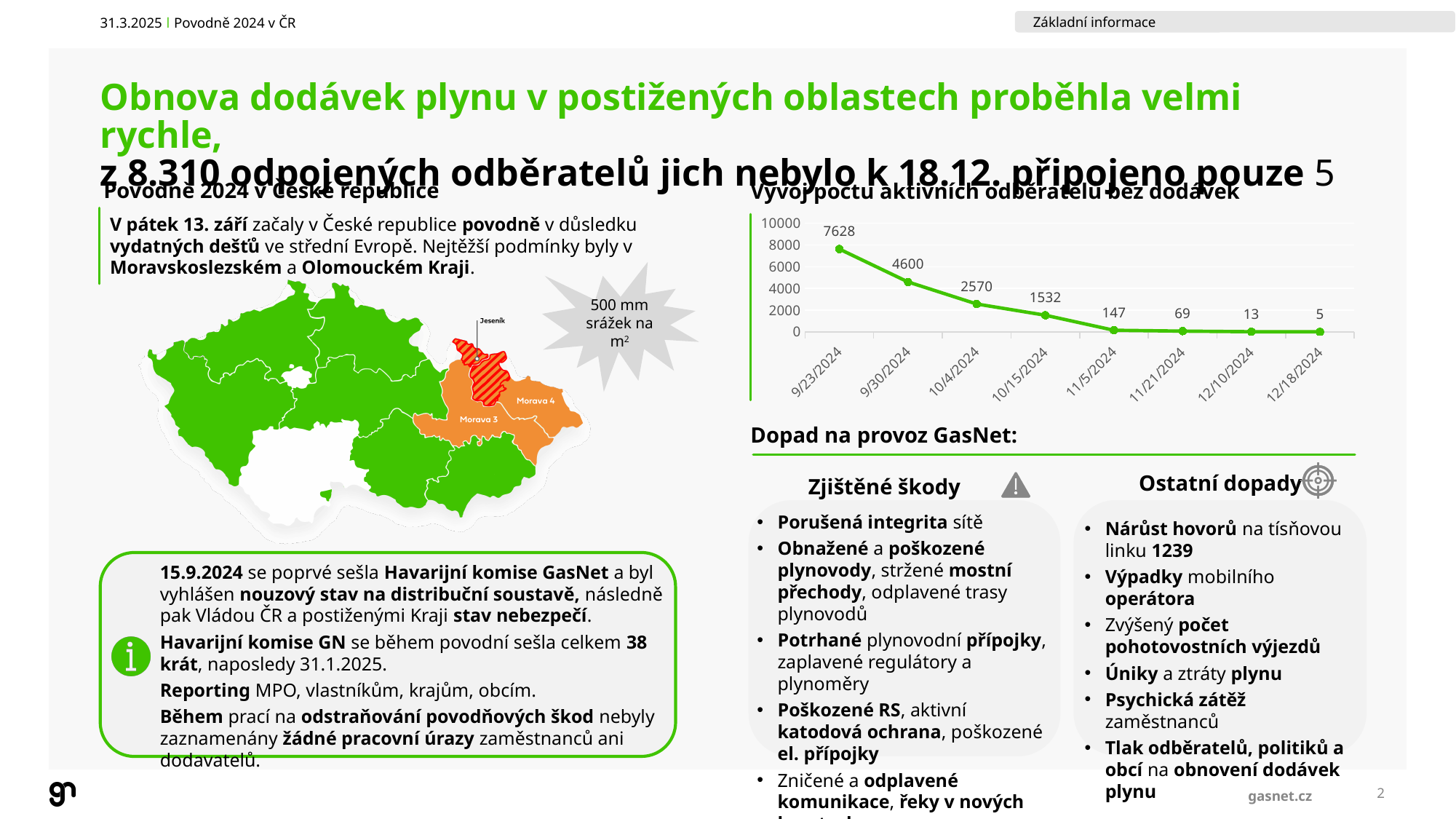
What is the value for 11/5/2024 in the line chart? 147 What type of chart is used to show the development of the number of active customers without supply? line chart What is the value for 9/23/2024 in the line chart? 7628 Do the values in the line chart rise or fall along the x axis? fall How many data points are plotted in the line chart? 8 Which is larger in the line chart: the value for 10/15/2024 or the value for 11/21/2024? 10/15/2024 Which date has the lowest value in the line chart? 12/18/2024 What is the difference between the values for 9/23/2024 and 9/30/2024 in the line chart? 3028 What is the value for 10/4/2024 in the line chart? 2570 Which date has the highest value in the line chart? 9/23/2024 What is the value for 12/18/2024 in the line chart? 5 What is the title of the line chart on the slide? Vývoj počtu aktivních odběratelů bez dodávek